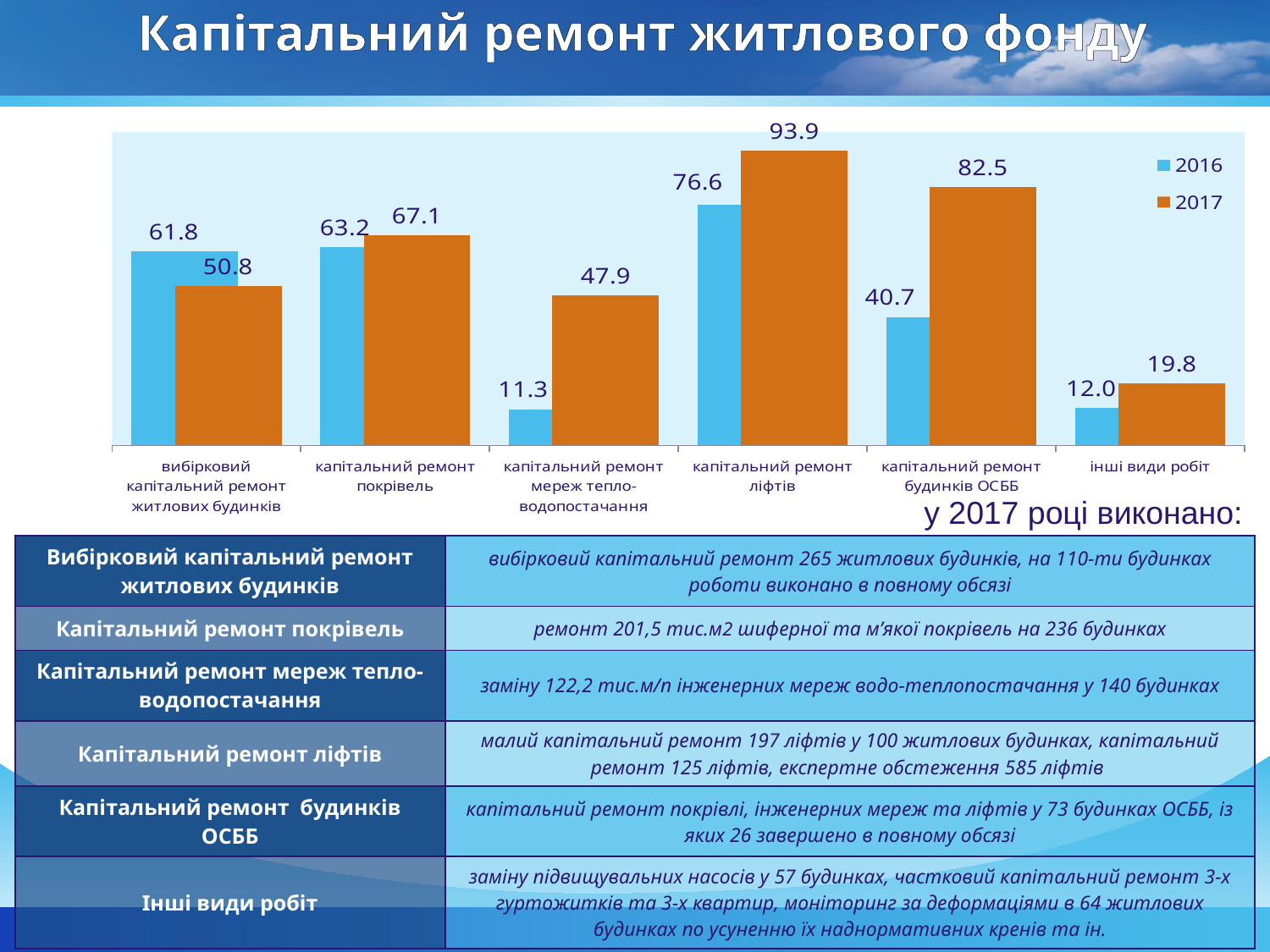
What is the 2017 value for капітальний ремонт ліфтів? 93.9 What type of chart is shown on the slide? bar chart How many categories are shown on the x axis of the chart? 6 What is the difference between the 2017 and 2016 values for інші види робіт? 7.8 Which category has the highest 2017 value? капітальний ремонт ліфтів Which category has the lowest 2016 value? капітальний ремонт мереж тепло-водопостачання What is the 2016 value for капітальний ремонт мереж тепло-водопостачання? 11.3 How many series does the chart legend list? 2 Which colour represents the 2017 series in the chart? orange What is the difference between the 2017 and 2016 values for капітальний ремонт будинків ОСББ? 41.8 For вибірковий капітальний ремонт житлових будинків, which year has the larger value, 2016 or 2017? 2016 What is the 2017 value for капітальний ремонт будинків ОСББ? 82.5